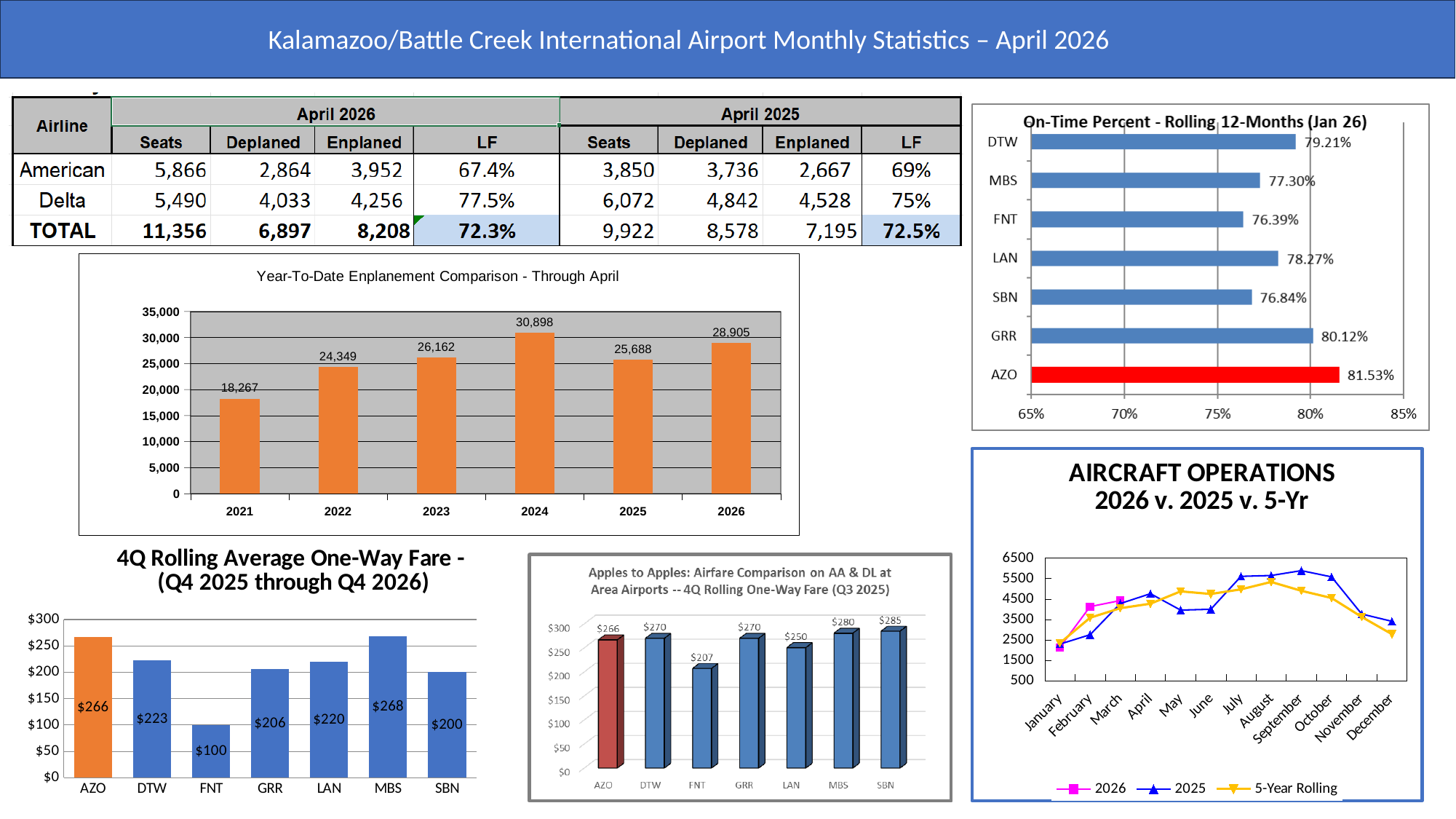
In the 4Q Rolling Average One-Way Fare chart, what is the difference between the MBS and FNT fares? $168 In the 4Q Rolling Average One-Way Fare chart, which airport has the highest fare? MBS In the Apples to Apples airfare comparison chart, what is the fare for SBN? $285 In the Year-To-Date Enplanement Comparison chart, which year has the highest enplanements? 2024 In the Year-To-Date Enplanement Comparison chart, what is the value for 2024? 30,898 In the Year-To-Date Enplanement Comparison chart, what is the difference between the 2026 and 2025 values? 3,217 In the On-Time Percent - Rolling 12-Months chart, how many airports are shown? 7 In the On-Time Percent - Rolling 12-Months chart, which airport has the lowest on-time percent? FNT In the On-Time Percent - Rolling 12-Months chart, what is the value for AZO? 81.53% In the Aircraft Operations chart, is the 2025 value for September greater or less than 5500? greater In the Aircraft Operations chart, how many series does the legend list? 3 In the 4Q Rolling Average One-Way Fare chart, what is the fare for FNT? $100